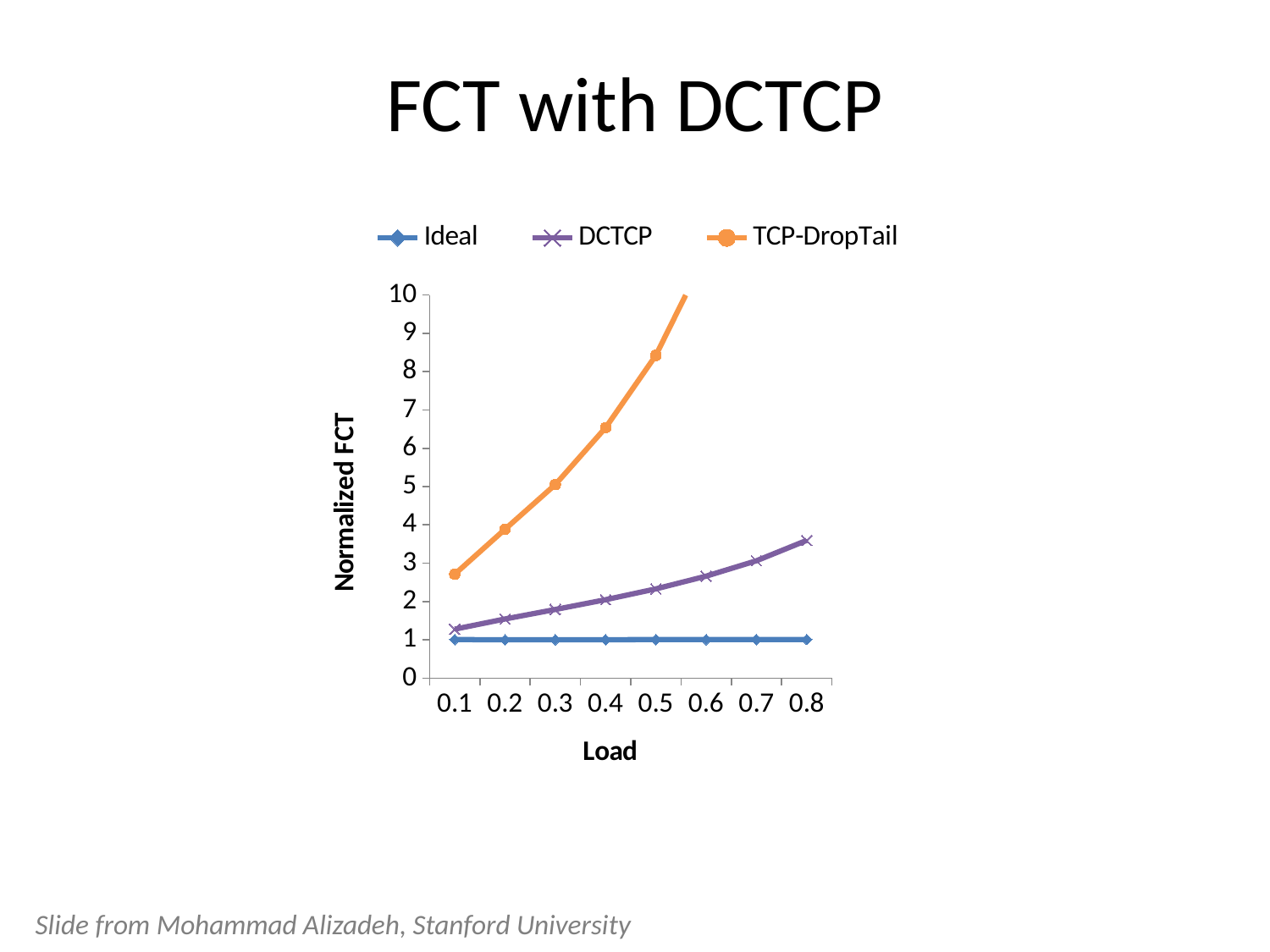
Does the Normalized FCT for TCP-DropTail rise or fall as Load increases? rise Is the Normalized FCT for TCP-DropTail at Load 0.5 greater or less than 8? greater What is the Normalized FCT for the Ideal series at Load 0.4? 1 Does the Normalized FCT for DCTCP rise or fall as Load increases? rise Is the Normalized FCT for TCP-DropTail at Load 0.1 greater or less than 2? greater What kind of chart is shown on the slide? line chart Is the Normalized FCT for DCTCP at Load 0.8 greater or less than 4? less How many series does the legend list? 3 Which series has the lowest Normalized FCT at Load 0.5? Ideal At Load 0.3, which series has the higher Normalized FCT, DCTCP or TCP-DropTail? TCP-DropTail How many Load values are shown on the x axis? 8 What is the label of the y axis? Normalized FCT